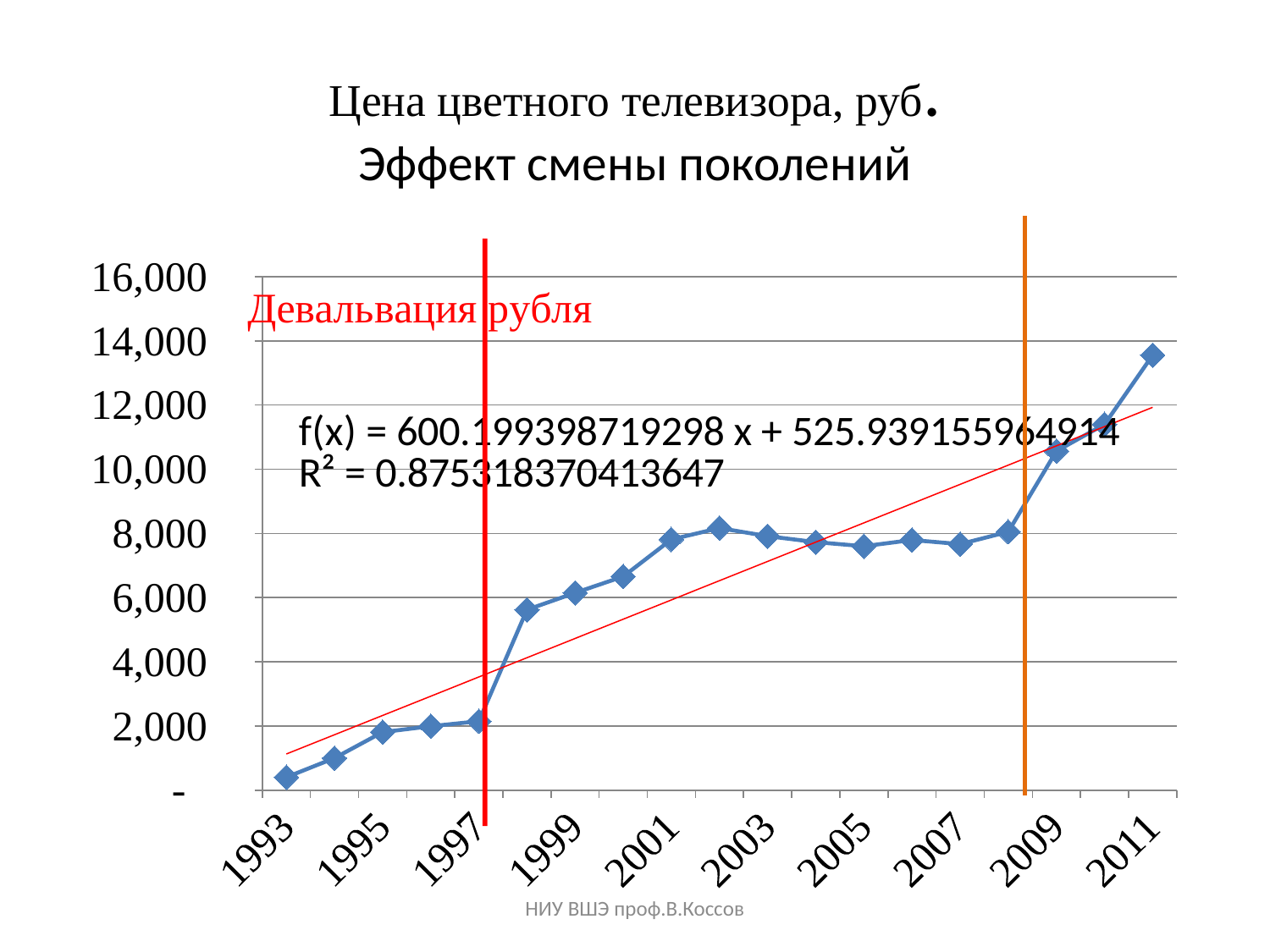
Which year has the larger value, 1995 or 2003? 2003 In which year is the plotted price lowest? 1993 Do the plotted values generally rise or fall from 1993 to 2011? rise Is the value for 2011 greater or less than 12,000? greater Is the value for 2001 greater or less than 6,000? greater In which year is the plotted price highest? 2011 How many data points are plotted on the line? 19 What R² value is printed on the chart for the trend line? 0.875318370413647 What is the title of the chart on the slide? Цена цветного телевизора, руб. Is the value for 1997 greater or less than 4,000? less What kind of chart is shown on the slide? line chart